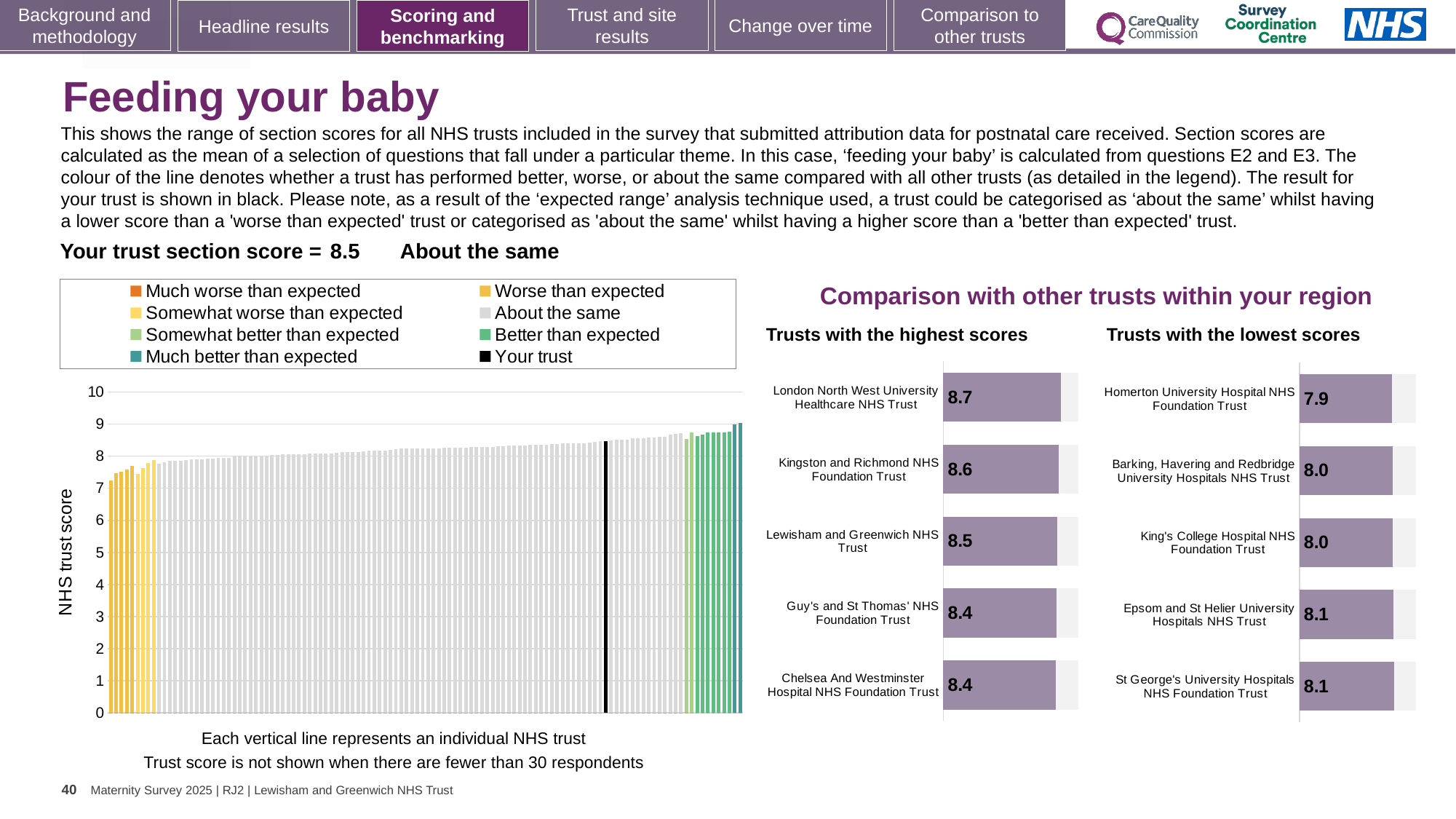
In the 'Trusts with the lowest scores' chart, what is the score for Homerton University Hospital NHS Foundation Trust? 7.9 In the 'Trusts with the highest scores' chart, what is the difference between the scores of London North West University Healthcare NHS Trust and Chelsea And Westminster Hospital NHS Foundation Trust? 0.3 In the 'Trusts with the lowest scores' chart, which trust has the lowest score? Homerton University Hospital NHS Foundation Trust In the 'Trusts with the lowest scores' chart, what is the difference between the scores of St George's University Hospitals NHS Foundation Trust and Homerton University Hospital NHS Foundation Trust? 0.2 In the 'Trusts with the lowest scores' chart, what is the score for Epsom and St Helier University Hospitals NHS Trust? 8.1 In the 'Trusts with the highest scores' chart, what is the score for Kingston and Richmond NHS Foundation Trust? 8.6 In the large chart on the left, is the value for the black 'Your trust' bar greater or less than 8? greater In the 'Trusts with the highest scores' chart, what is the score for London North West University Healthcare NHS Trust? 8.7 Which has a higher score: Kingston and Richmond NHS Foundation Trust in the highest scores chart, or Epsom and St Helier University Hospitals NHS Trust in the lowest scores chart? Kingston and Richmond NHS Foundation Trust In the 'Trusts with the highest scores' chart, which trust has the highest score? London North West University Healthcare NHS Trust How many entries does the legend of the large chart on the left list? 8 How many trusts are shown in the 'Trusts with the highest scores' chart? 5